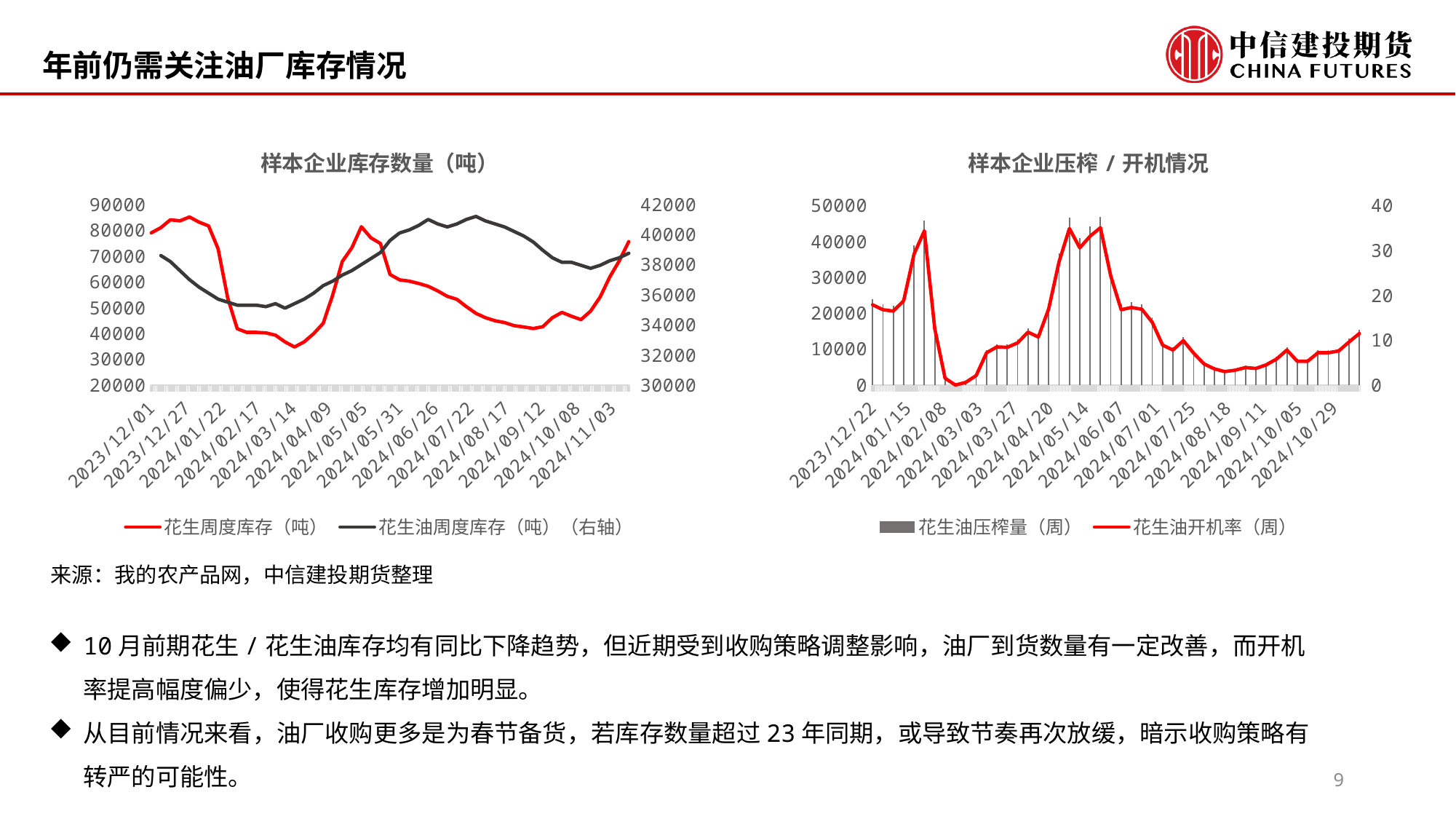
On the chart titled 样本企业库存数量（吨）, how many series does the legend list? 2 On the chart titled 样本企业压榨／开机情况, how many series does the legend list? 2 On the chart titled 样本企业库存数量（吨）, which series is plotted on the right axis? 花生油周度库存（吨）（右轴） On the chart titled 样本企业压榨／开机情况, is the value of 花生油压榨量（周） at 2024/03/03 greater or less than 10000? less On the chart titled 样本企业库存数量（吨）, is the value of 花生周度库存（吨） at 2024/03/14 greater or less than 40000? less On the chart titled 样本企业压榨／开机情况, does 花生油开机率（周） rise or fall between 2024/06/07 and 2024/08/18? fall On the chart titled 样本企业库存数量（吨）, what kind of chart is it? line chart On the chart titled 样本企业库存数量（吨）, is the value of 花生周度库存（吨） at 2023/12/01 greater or less than 70000? greater On the chart titled 样本企业压榨／开机情况, which series is drawn as bars? 花生油压榨量（周） On the chart titled 样本企业库存数量（吨）, does 花生周度库存（吨） rise or fall between 2024/05/05 and 2024/09/12? fall